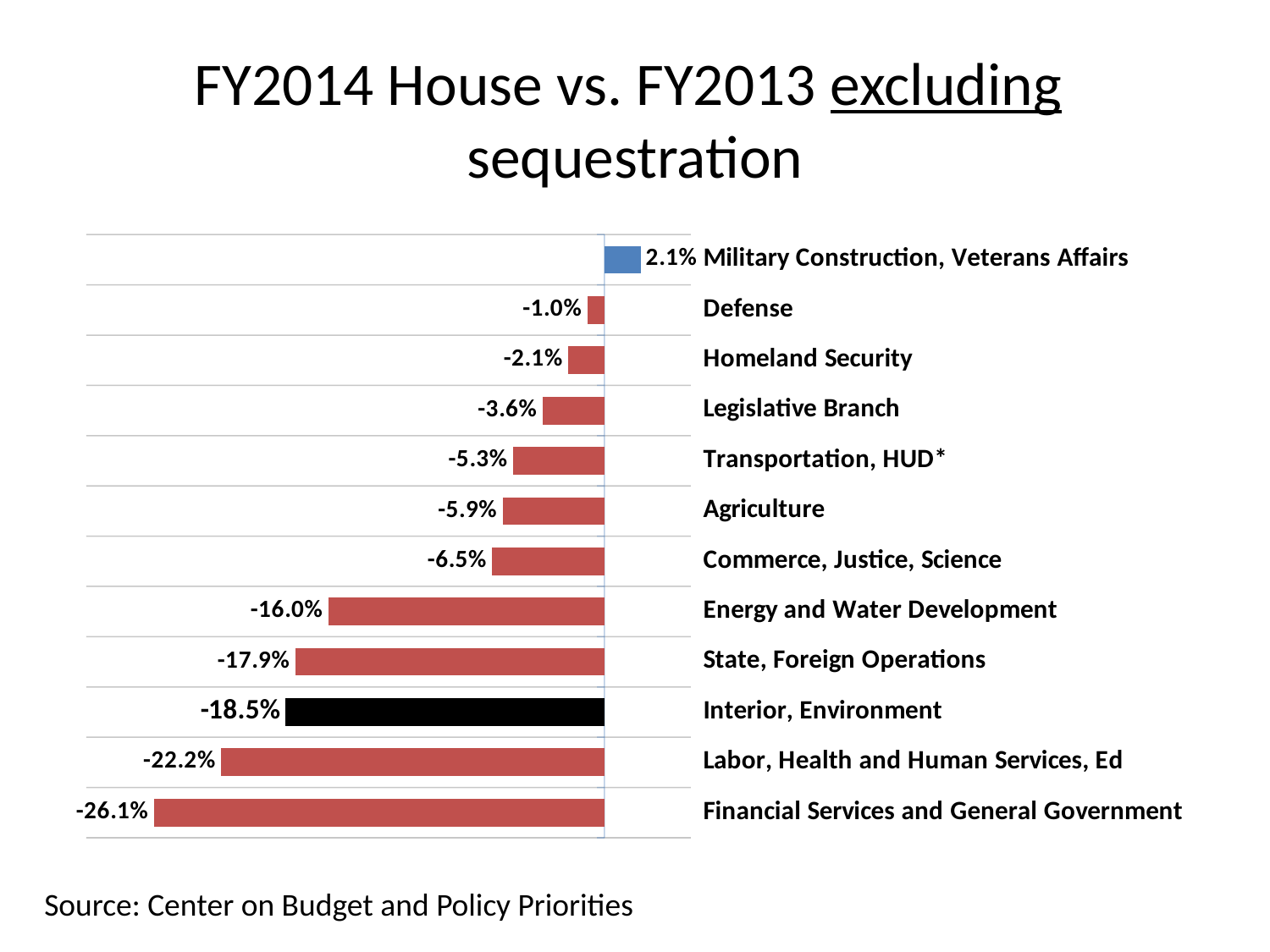
What kind of chart is shown on the slide? Bar chart How many categories have a positive value? 1 What is the difference between the values for Labor, Health and Human Services, Ed and Financial Services and General Government? 3.9 percentage points Which is larger, the value for Defense or the value for Homeland Security? Defense Which bar is coloured black? Interior, Environment What is the value for Interior, Environment? -18.5% Which category has the highest value? Military Construction, Veterans Affairs What is the value for Military Construction, Veterans Affairs? 2.1% How many categories are shown in the chart? 12 What source is cited for the chart? Center on Budget and Policy Priorities Which category has the lowest value? Financial Services and General Government What is the value for Energy and Water Development? -16.0%